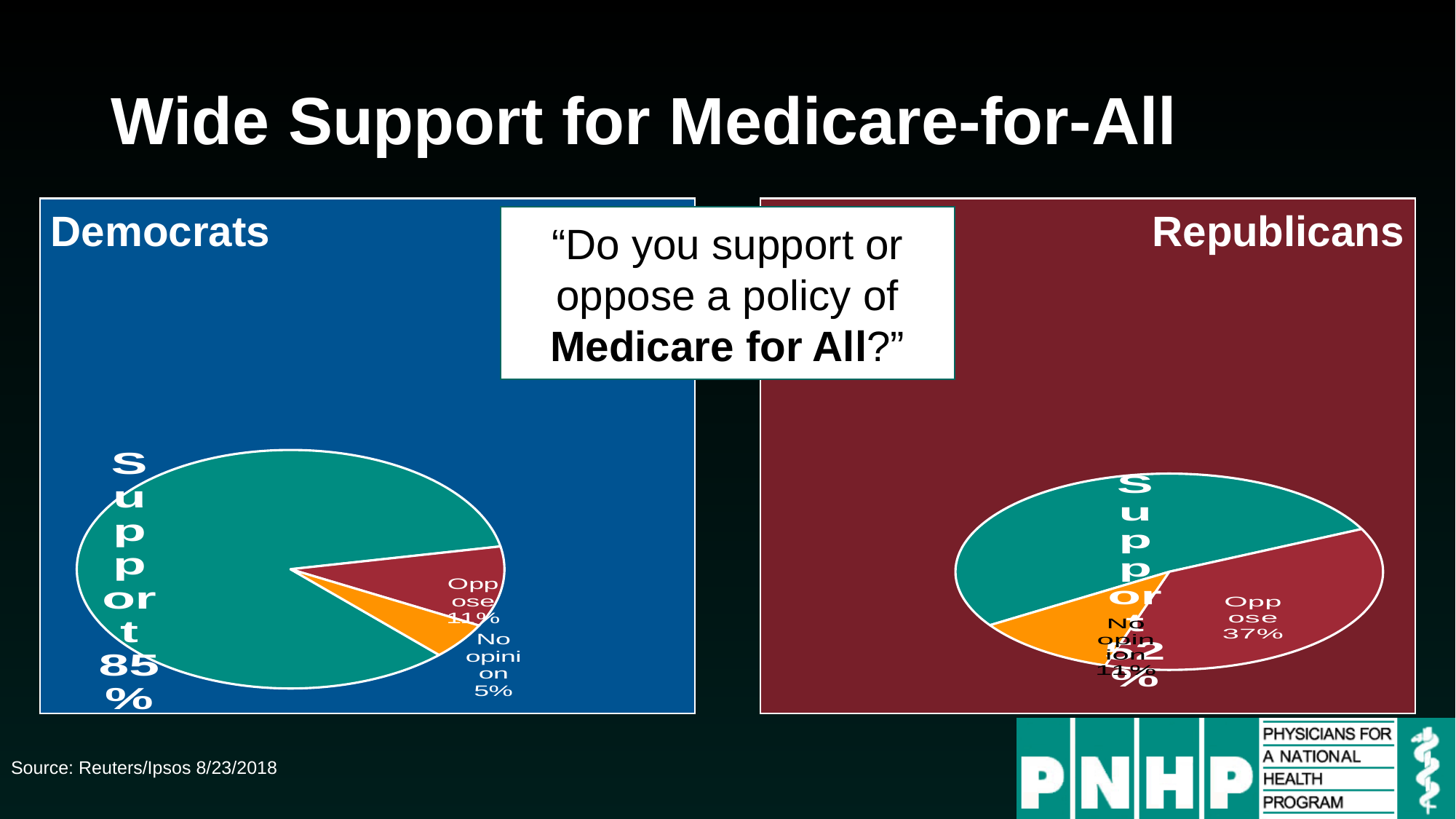
In the Democrats pie chart, what percentage support Medicare for All? 85% In the Republicans pie chart, which response is the largest slice? Support In the Democrats pie chart, which response is the largest slice? Support In the Republicans pie chart, what percentage oppose Medicare for All? 37% What kind of chart is used on the Democrats panel? Pie chart In the Democrats pie chart, which response is the smallest slice? No opinion What source is cited for the data on the slide? Reuters/Ipsos 8/23/2018 In the Democrats pie chart, how many percentage points higher is Support than Oppose? 74 In the Democrats pie chart, what percentage oppose Medicare for All? 11% In the Democrats pie chart, what percentage have no opinion? 5% How many slices does the Democrats pie chart have? 3 Which group has a larger Oppose share, Democrats or Republicans? Republicans